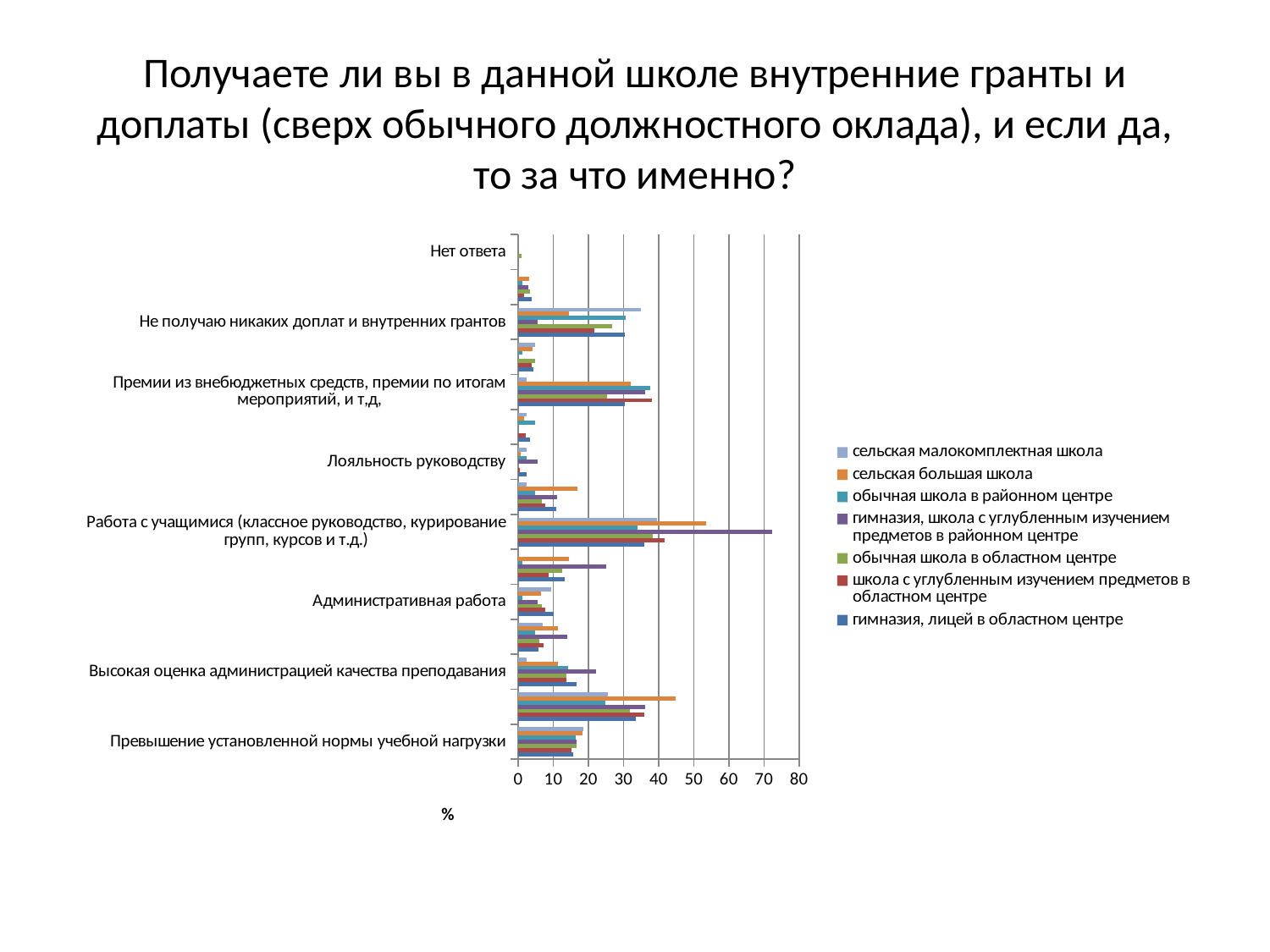
Is the value for "сельская большая школа" in the category "Превышение установленной нормы учебной нагрузки" greater or less than 20? less What kind of chart is shown on the slide? bar chart Which series has the highest value for "Высокая оценка администрацией качества преподавания"? гимназия, школа с углубленным изучением предметов в районном центре What unit label is shown below the horizontal axis of the chart? % Is the value for "гимназия, школа с углубленным изучением предметов в районном центре" in the category "Работа с учащимися (классное руководство, курирование групп, курсов и т.д.)" greater or less than 60? greater How many series does the legend list? 7 Is the value for "сельская малокомплектная школа" in the category "Не получаю никаких доплат и внутренних грантов" greater or less than 30? greater Which series has the highest value for "Не получаю никаких доплат и внутренних грантов"? сельская малокомплектная школа Which series has the lowest value for "Не получаю никаких доплат и внутренних грантов"? гимназия, школа с углубленным изучением предметов в районном центре Which series has the highest value for "Работа с учащимися (классное руководство, курирование групп, курсов и т.д.)"? гимназия, школа с углубленным изучением предметов в районном центре For "Работа с учащимися (классное руководство, курирование групп, курсов и т.д.)", which is larger: the value for "сельская большая школа" or for "обычная школа в районном центре"? сельская большая школа